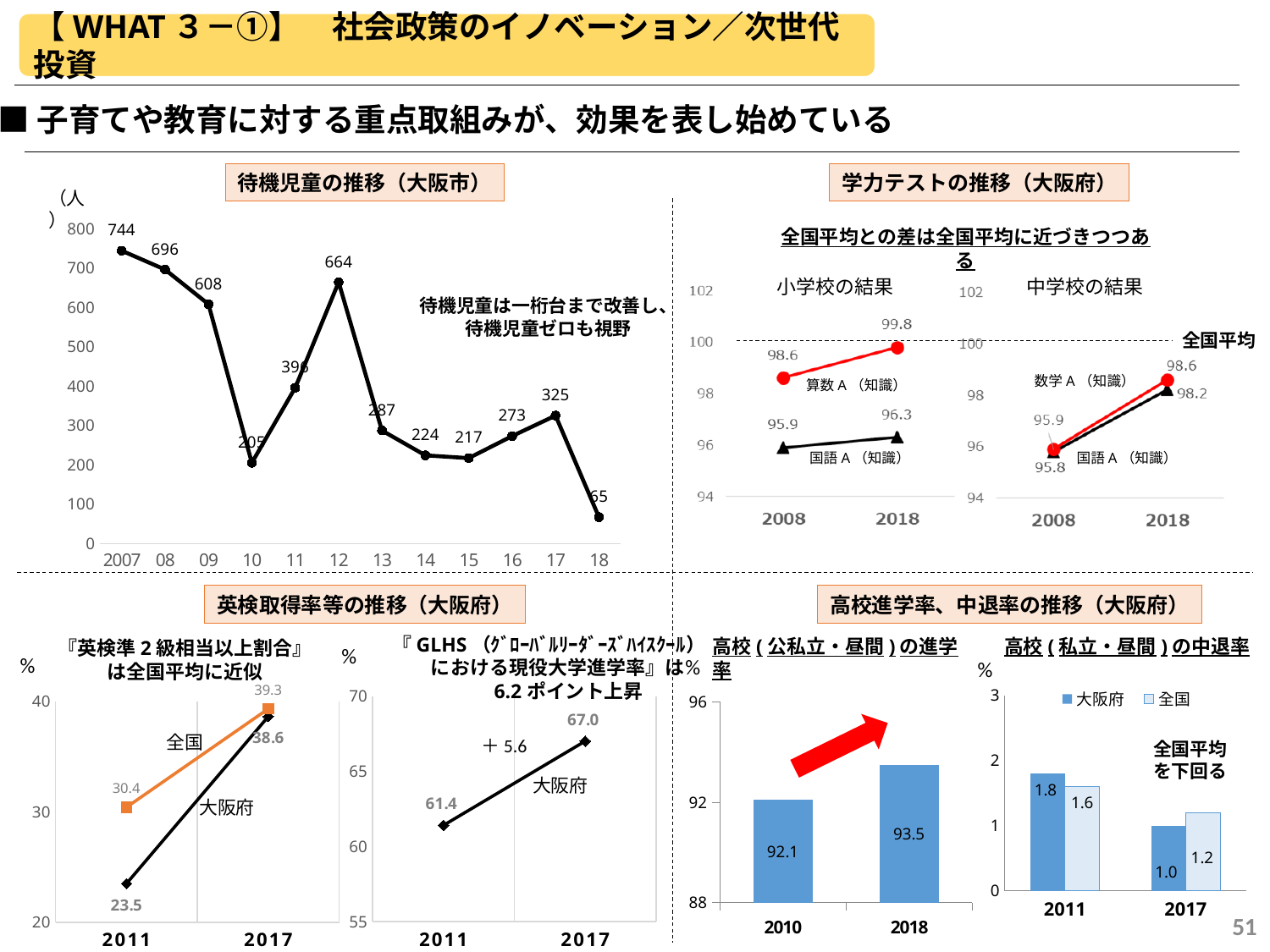
In the 高校（公私立・昼間）の進学率 bar chart, what is the value for 2018? 93.5 In the 中学校の結果 chart under 学力テストの推移（大阪府）, what is the difference between the 数学A（知識） values for 2008 and 2018? 2.7 In the 小学校の結果 chart under 学力テストの推移（大阪府）, what is the value for 算数A（知識） in 2018? 99.8 In the GLHS 現役大学進学率 chart, what is the value for 2017? 67.0 What kind of chart is the 待機児童の推移（大阪市） chart? line chart In the 待機児童の推移（大阪市） chart, how many years are plotted? 12 In the 英検準2級相当以上割合 chart, which is larger in 2017, 全国 or 大阪府? 全国 In the 英検準2級相当以上割合 chart, what is the value for 大阪府 in 2011? 23.5 In the 高校（私立・昼間）の中退率 chart, how many series does the legend list? 2 In the 待機児童の推移（大阪市） chart, what is the value for 2007? 744 In the 待機児童の推移（大阪市） chart, which year has the lowest value? 18 In the 待機児童の推移（大阪市） chart, what is the difference between the values for 2007 and 18? 679